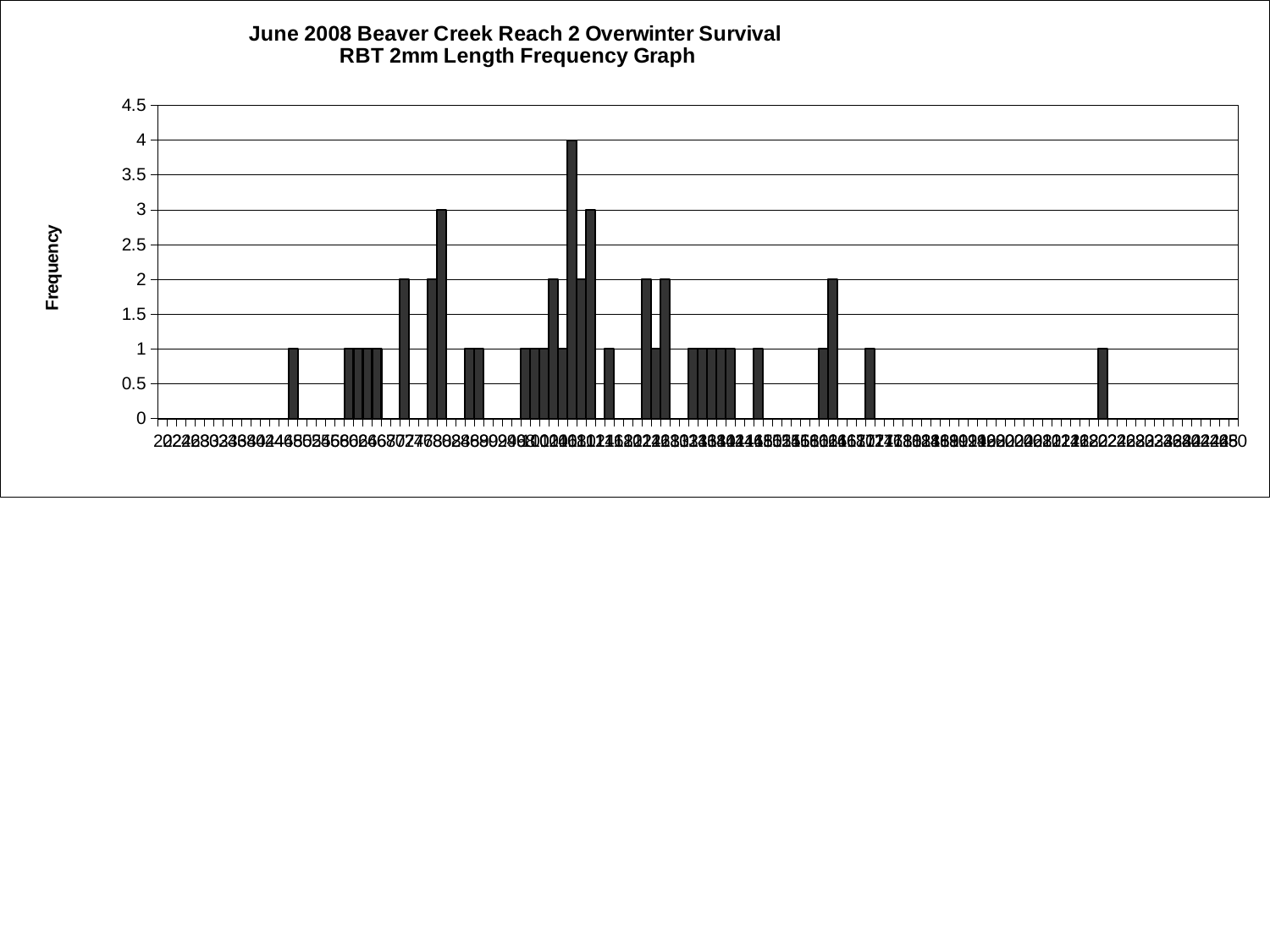
What is the highest frequency value reached by any bar in the chart? 4 How many bars in the chart reach a frequency of 4? 1 How many bars in the chart reach a frequency of 3? 2 Is the tallest bar in the chart greater or less than 3.5? greater What kind of chart is shown on the slide? bar chart What is the title of the chart? June 2008 Beaver Creek Reach 2 Overwinter Survival RBT 2mm Length Frequency Graph What is the maximum value shown on the vertical axis of the chart? 4.5 What is the label on the vertical axis of the chart? Frequency